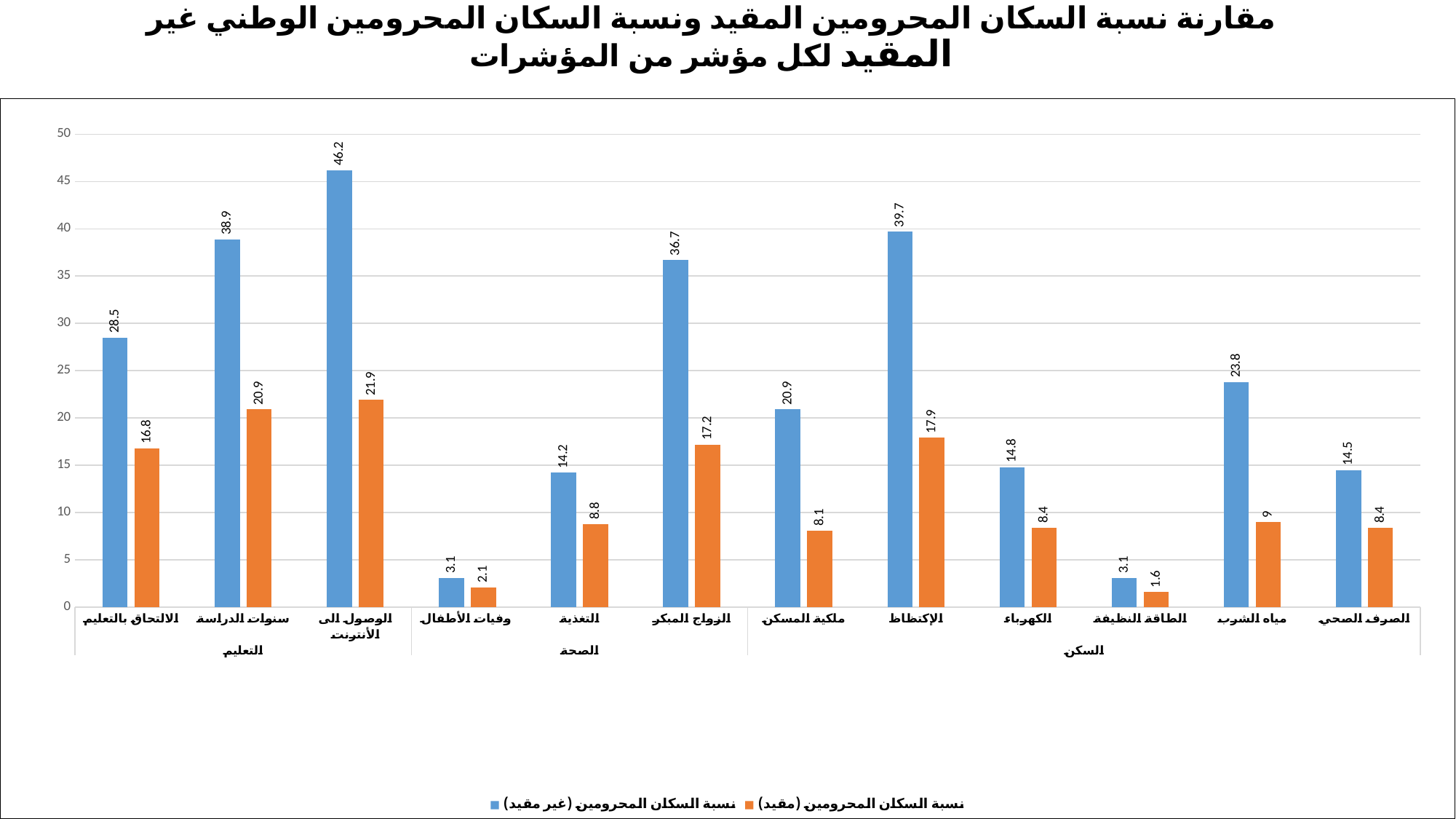
What kind of chart is shown on the slide? Bar chart How many series does the legend list? 2 Which category has the lowest value in the orange series (مقيد)? الطاقة النظيفة Which category has the highest value in the blue series (غير مقيد)? الوصول إلى الأنترنت What is the value of the orange series (مقيد) for مياه الشرب? 9 What is the value of the orange series (مقيد) for الإكتظاظ? 17.9 Which colour represents the series نسبة السكان المحرومين (مقيد)? Orange How many categories are shown on the x axis? 12 What is the difference between the blue (غير مقيد) and orange (مقيد) values for الزواج المبكر? 19.5 What is the value of the blue series (غير مقيد) for الوصول إلى الأنترنت? 46.2 Which is larger: the blue (غير مقيد) value for سنوات الدراسة or for الإكتظاظ? الإكتظاظ What is the value of the blue series (غير مقيد) for التغذية? 14.2